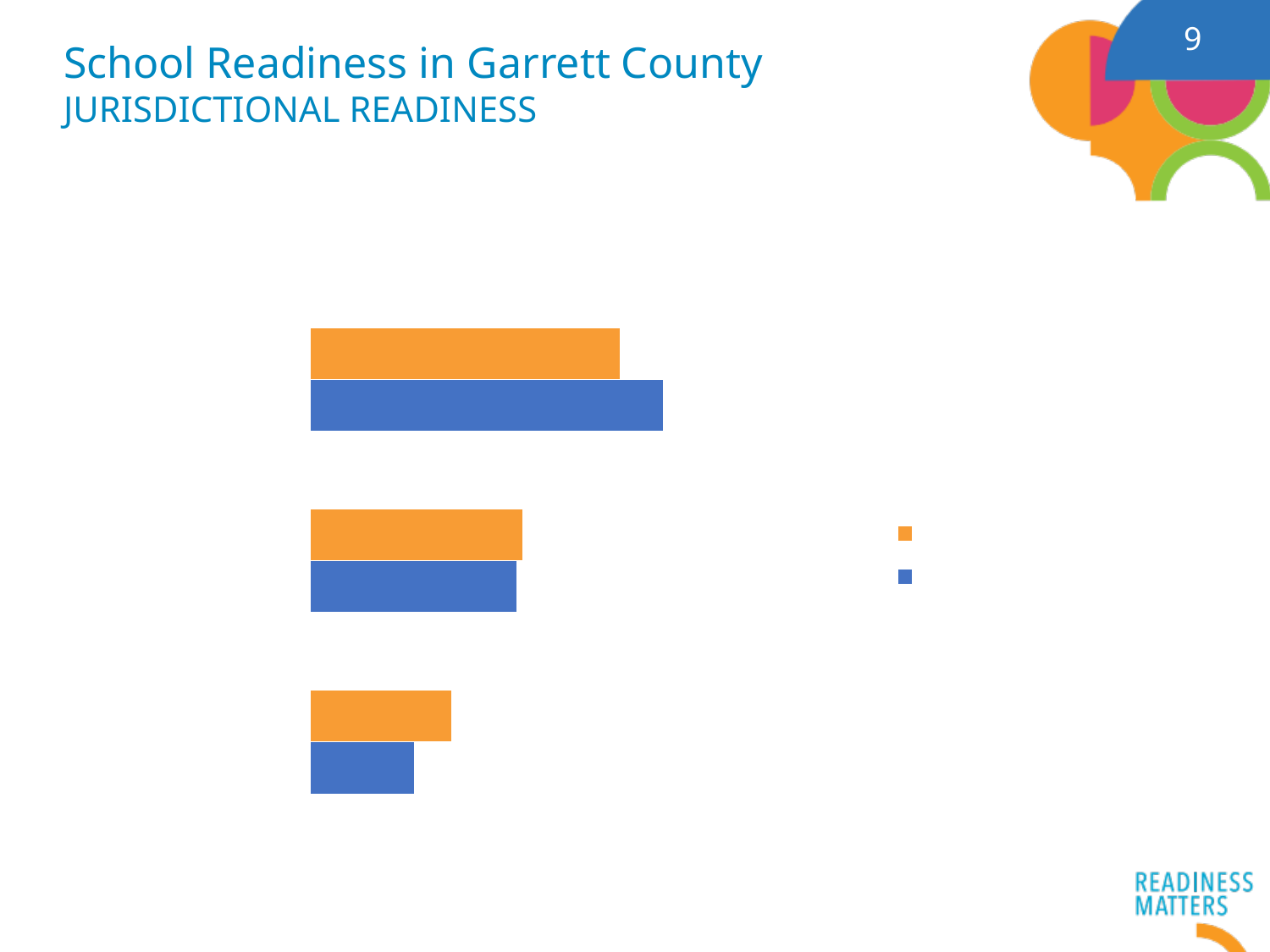
Are the bars in the chart drawn horizontally or vertically? horizontally What kind of chart is shown on the slide? bar chart In the top group of bars, is the orange bar or the blue bar longer? blue Which single bar is the shortest in the chart? the blue bar in the bottom group What two colours are used for the bars in the chart? orange and blue Going from the top group to the bottom group, do the blue bars get longer or shorter? shorter In the bottom group of bars, is the orange bar or the blue bar longer? orange How many series does the chart's legend list? 2 How many groups of bars are plotted in the chart? 3 Which single bar is the longest in the chart? the blue bar in the top group Going from the top group to the bottom group, do the orange bars get longer or shorter? shorter